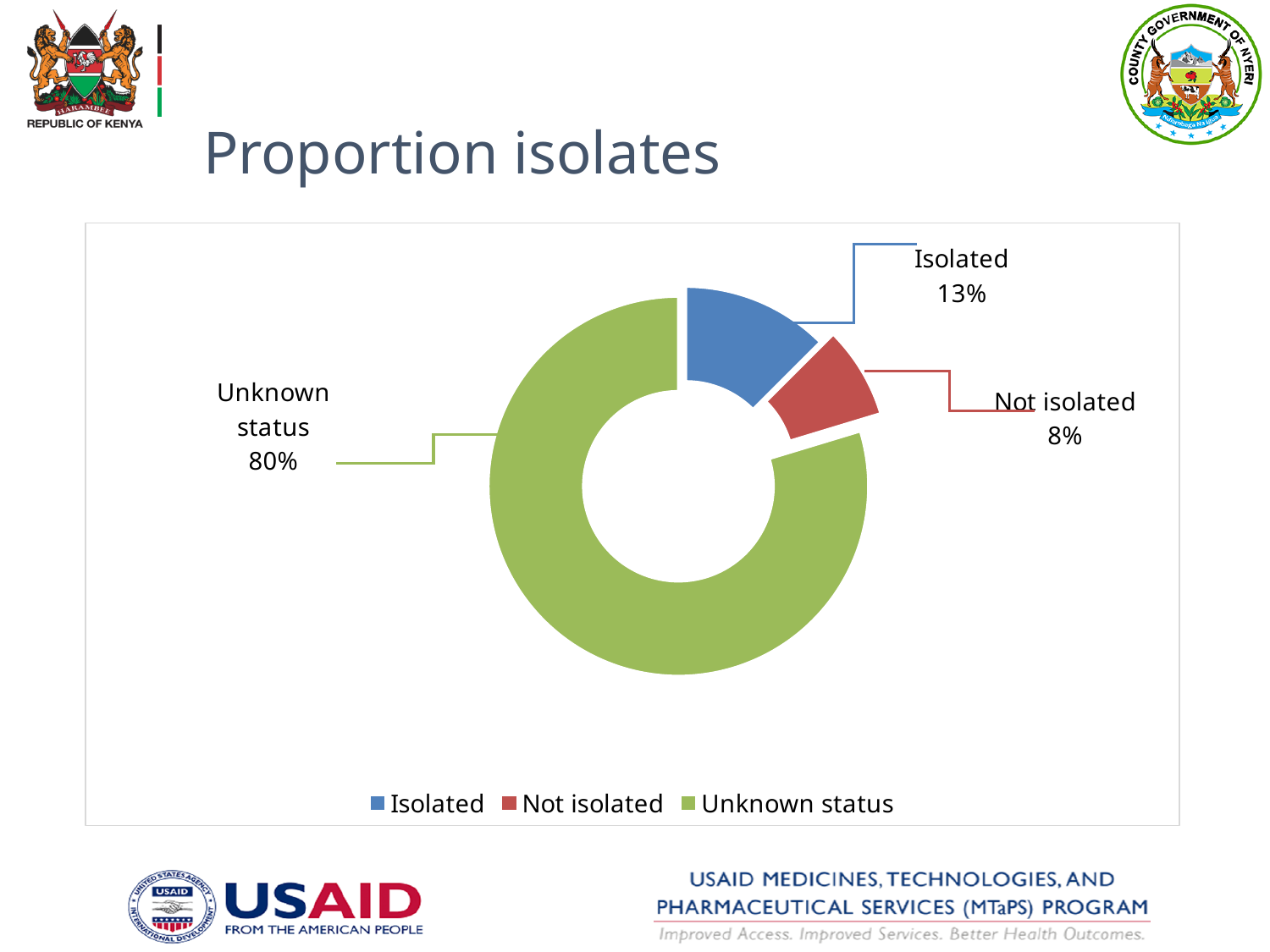
Which category has the smallest share of the chart? Not isolated What is the difference in percentage points between Isolated and Not isolated? 5 What colour represents Unknown status in the chart? Green What percentage of isolates are shown as Not isolated? 8% What percentage of isolates have Unknown status? 80% What is the difference in percentage points between Unknown status and Isolated? 67 What kind of chart is shown on the slide? Doughnut (pie) chart What percentage of isolates are shown as Isolated? 13% How many entries does the legend list? 3 Which is larger, the share for Isolated or the share for Not isolated? Isolated How many categories are shown in the chart? 3 Which category has the largest share of the chart? Unknown status